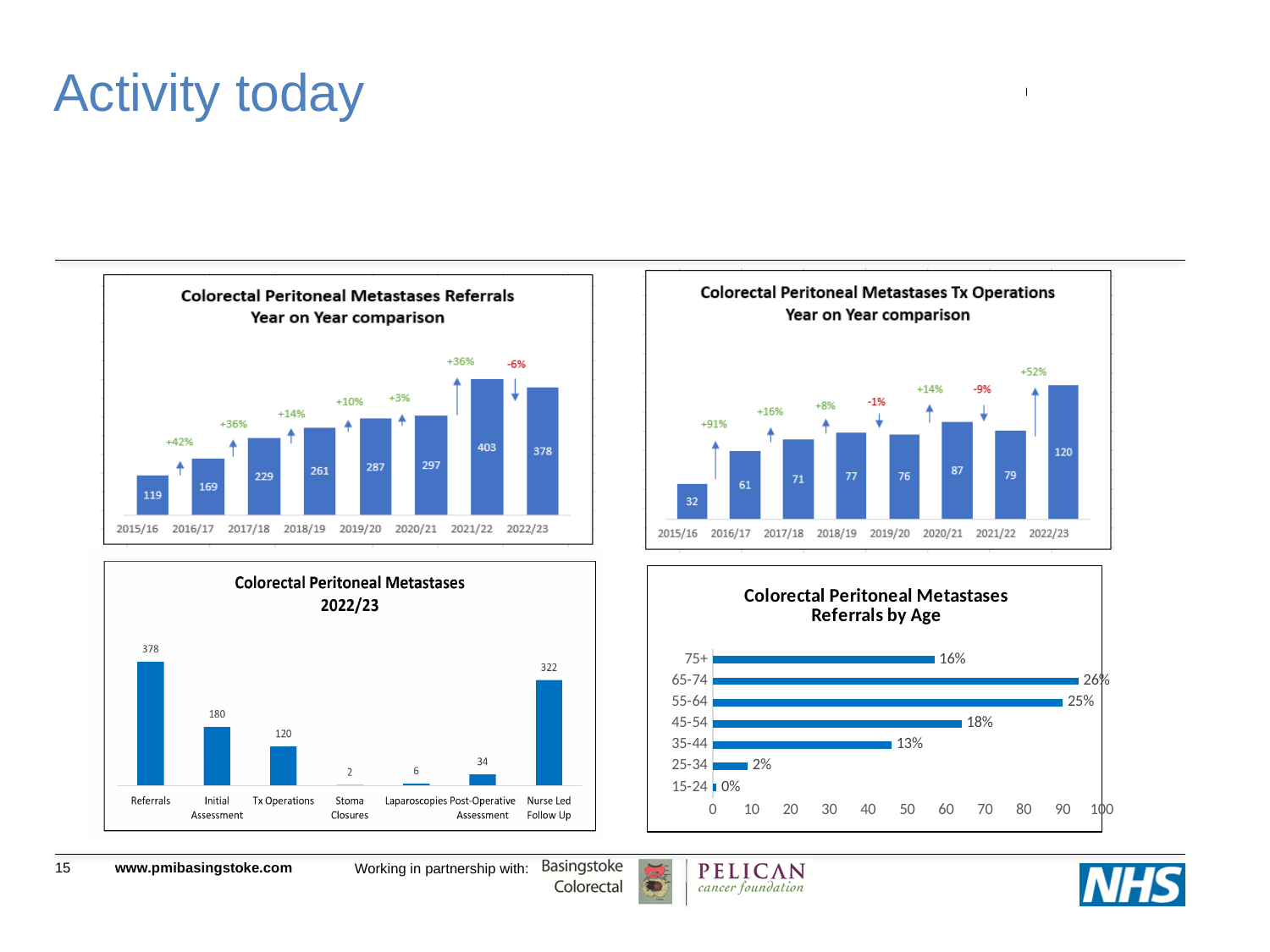
In the 'Colorectal Peritoneal Metastases Referrals Year on Year comparison' chart, which year has the lowest value? 2015/16 In the 'Colorectal Peritoneal Metastases Tx Operations Year on Year comparison' chart, what percentage change is labelled above the 2016/17 bar? +91% In the 'Colorectal Peritoneal Metastases Tx Operations Year on Year comparison' chart, what is the value for 2022/23? 120 In the 'Colorectal Peritoneal Metastases 2022/23' chart, what is the value for Nurse Led Follow Up? 322 In the 'Colorectal Peritoneal Metastases Referrals by Age' chart, what is the value for the 65-74 age group? 26% In the 'Colorectal Peritoneal Metastases Referrals Year on Year comparison' chart, what is the value for 2021/22? 403 In the 'Colorectal Peritoneal Metastases Tx Operations Year on Year comparison' chart, how many years are shown? 8 In the 'Colorectal Peritoneal Metastases Referrals Year on Year comparison' chart, what is the difference between the 2021/22 and 2022/23 values? 25 What type of chart is the 'Colorectal Peritoneal Metastases Referrals by Age' chart? Bar chart In the 'Colorectal Peritoneal Metastases Tx Operations Year on Year comparison' chart, which year has the highest value? 2022/23 In the 'Colorectal Peritoneal Metastases 2022/23' chart, is the value for Initial Assessment larger or smaller than the value for Tx Operations? larger In the 'Colorectal Peritoneal Metastases 2022/23' chart, which category has the lowest value? Stoma Closures